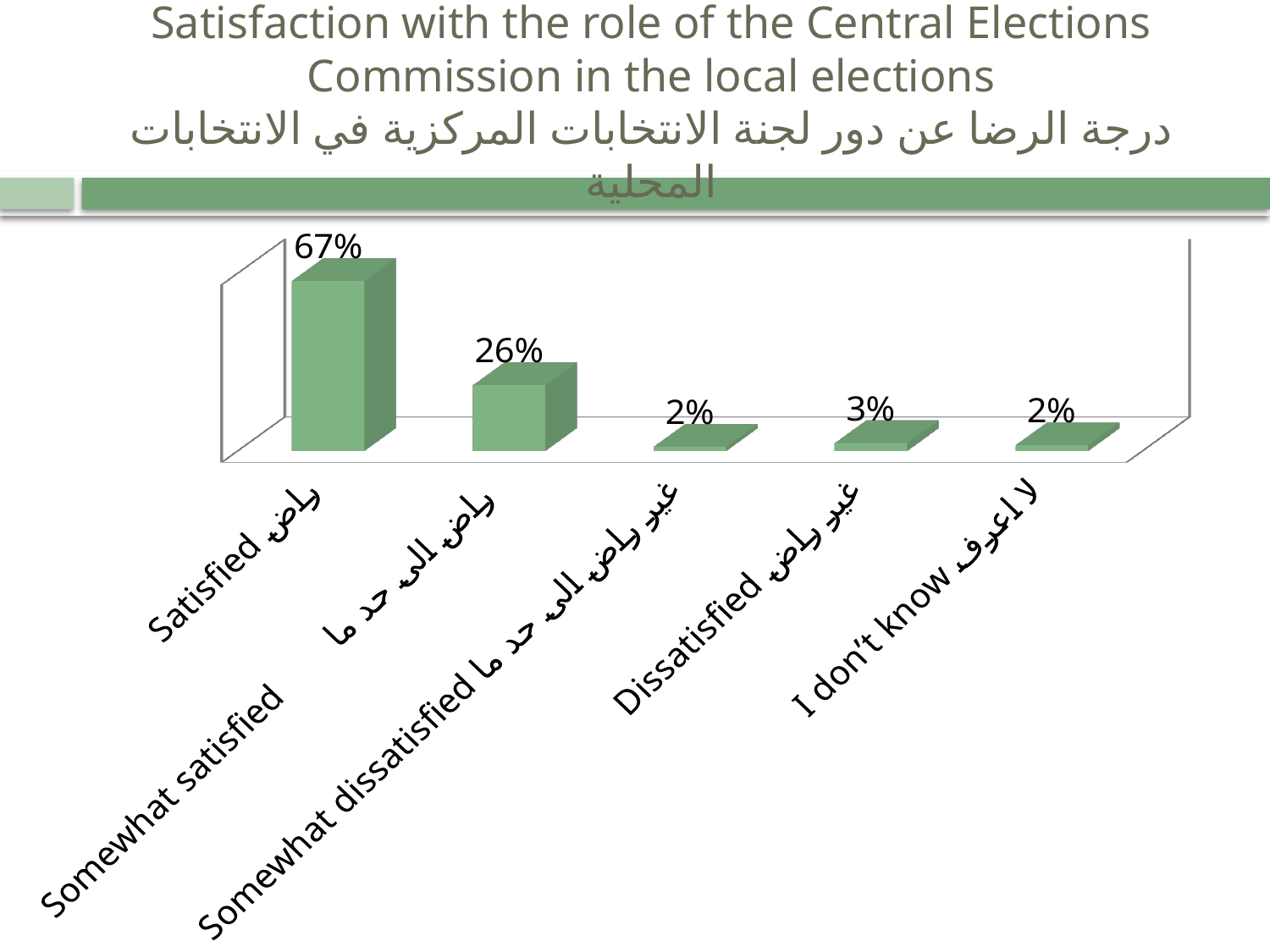
What is the value shown for Somewhat dissatisfied? 2% What kind of chart is shown on the slide? Bar chart What is the value shown for Somewhat satisfied? 26% How many categories are shown in the chart? 5 What percentage of respondents are Satisfied with the role of the Central Elections Commission? 67% What is the value shown for Dissatisfied? 3% Which is larger, the value for Dissatisfied or the value for Somewhat dissatisfied? Dissatisfied What is the difference between the Satisfied and Somewhat satisfied values? 41% What is the English title of the chart on the slide? Satisfaction with the role of the Central Elections Commission in the local elections What is the combined value of Satisfied and Somewhat satisfied? 93% What is the value shown for I don't know? 2% Which category has the highest value? Satisfied